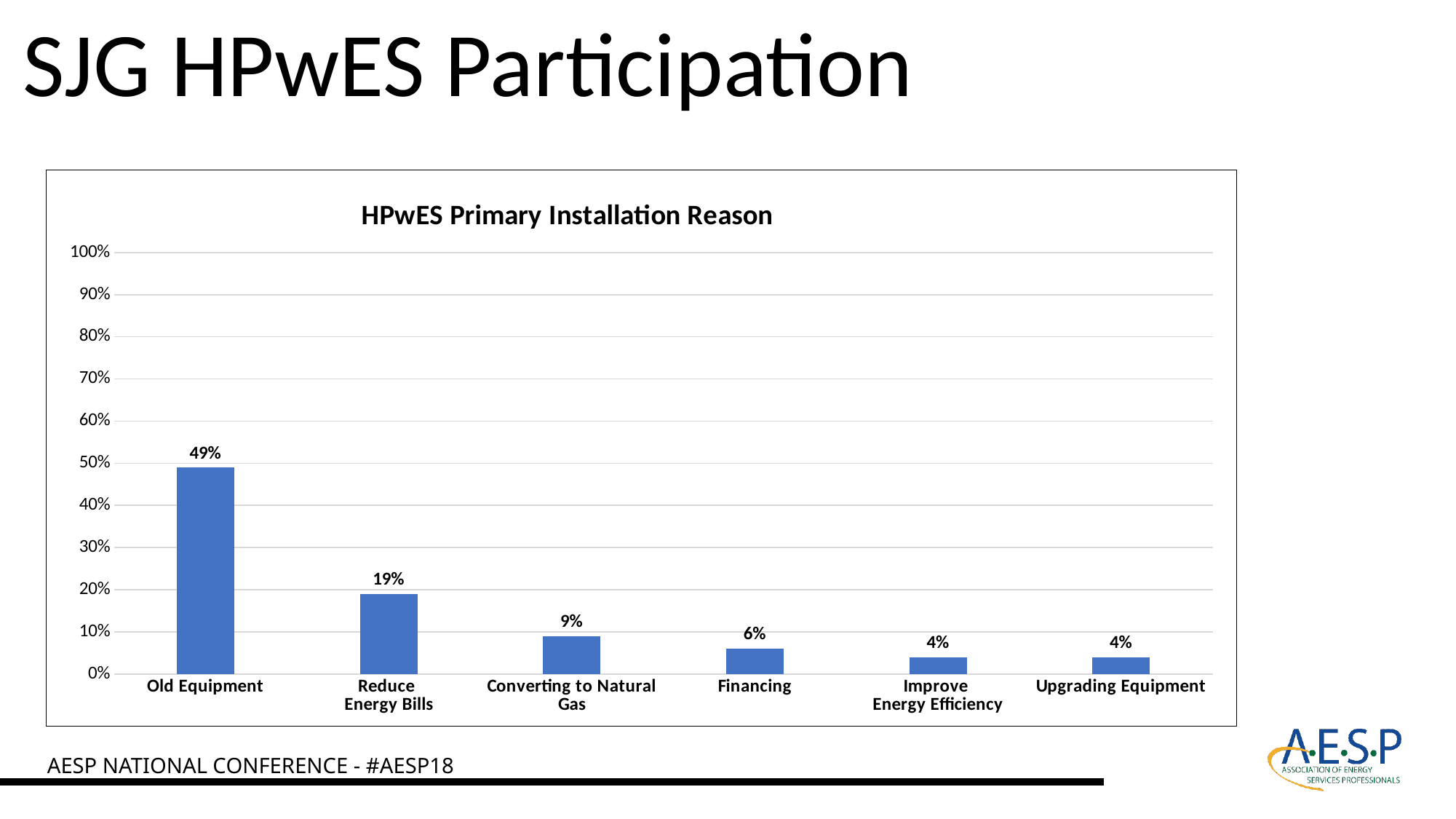
Is the value for Reduce Energy Bills greater or less than 10%? greater Do the values rise or fall from left to right along the x axis? fall What kind of chart is shown? bar chart What is the value for Reduce Energy Bills? 19% What is the value for Converting to Natural Gas? 9% What is the title of the chart? HPwES Primary Installation Reason What is the value for Old Equipment? 49% What is the difference between the values for Old Equipment and Reduce Energy Bills? 30% How many categories are shown on the x axis? 6 What is the value for Financing? 6% Which category has the highest value? Old Equipment Which is larger, the value for Converting to Natural Gas or the value for Financing? Converting to Natural Gas